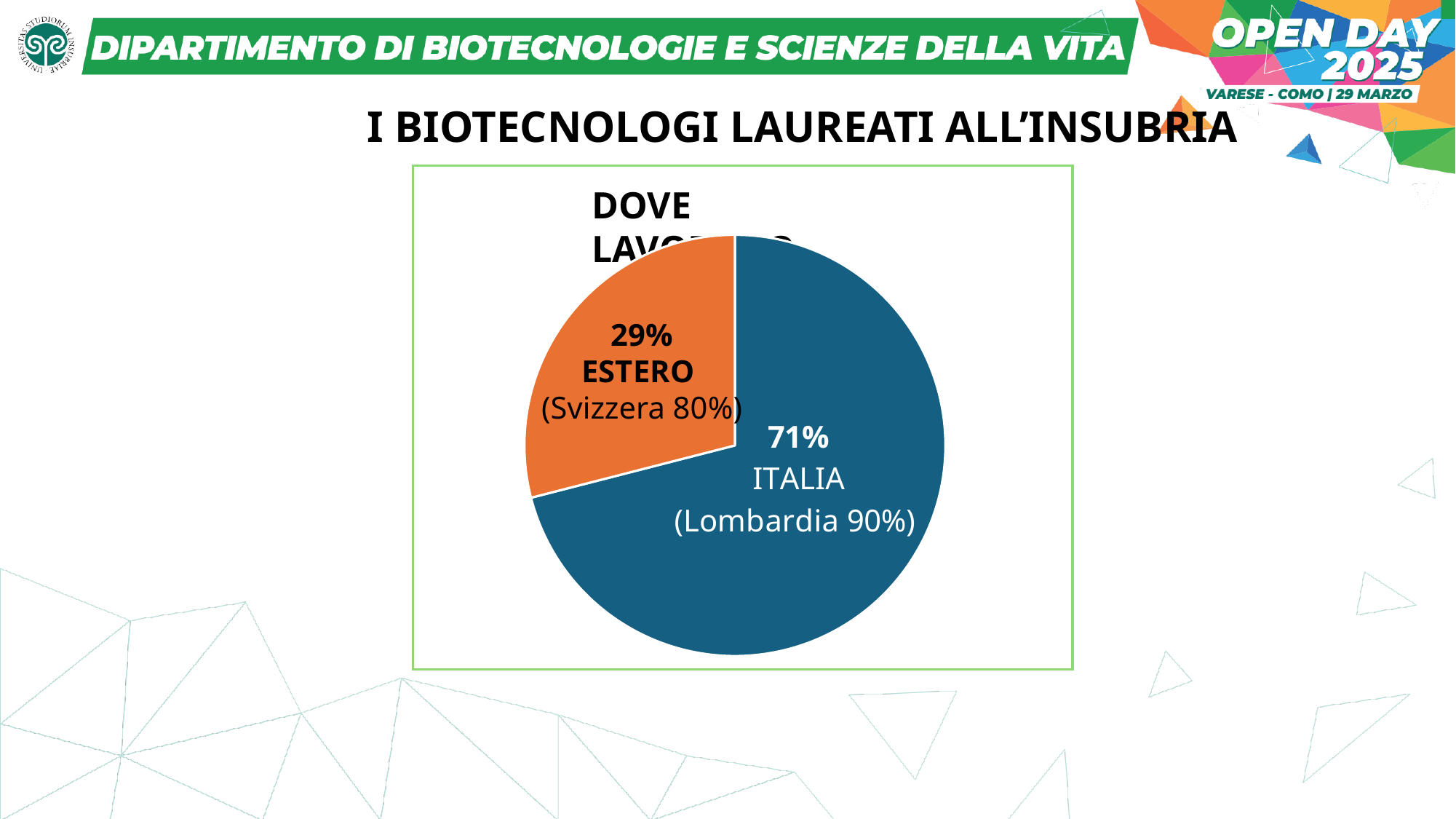
What percentage is given in parentheses for Lombardia within the ITALIA slice? 90% Which slice is larger, ITALIA or ESTERO? ITALIA What share of the pie is labelled ITALIA? 71% What kind of chart is shown on the slide? pie chart Which slice of the pie is the largest? ITALIA What colour is the ITALIA slice of the pie? blue How many slices does the pie chart have? 2 What share of the pie is labelled ESTERO? 29% What colour is the ESTERO slice of the pie? orange What percentage is given in parentheses for Svizzera within the ESTERO slice? 80% Which slice of the pie is the smallest? ESTERO What is the difference in percentage points between the ITALIA slice and the ESTERO slice? 42